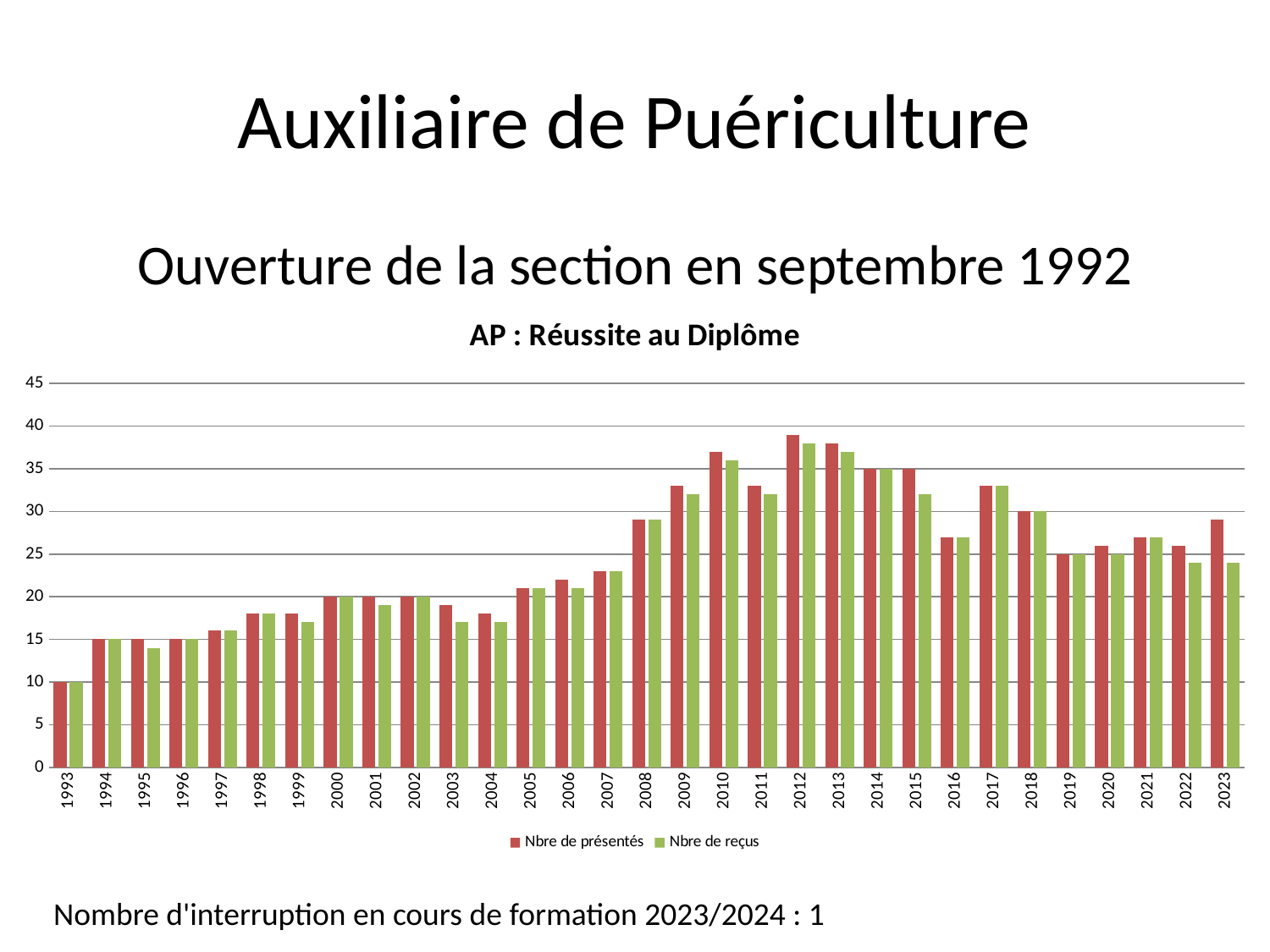
What is the title of the chart? AP : Réussite au Diplôme How many series does the legend list? 2 What is the value of Nbre de présentés for 1993? 10 Which year has the lowest value for Nbre de présentés? 1993 How many years are shown on the x axis? 31 What are the two series named in the legend? Nbre de présentés, Nbre de reçus Is the value of Nbre de reçus for 2022 greater or less than 25? less Is the value of Nbre de présentés for 2012 greater or less than 35? greater What is the value of Nbre de présentés for 2018? 30 What is the value of Nbre de reçus for 2000? 20 Do the values for Nbre de présentés generally rise or fall from 1993 to 2012? rise What type of chart is shown on the slide? bar chart